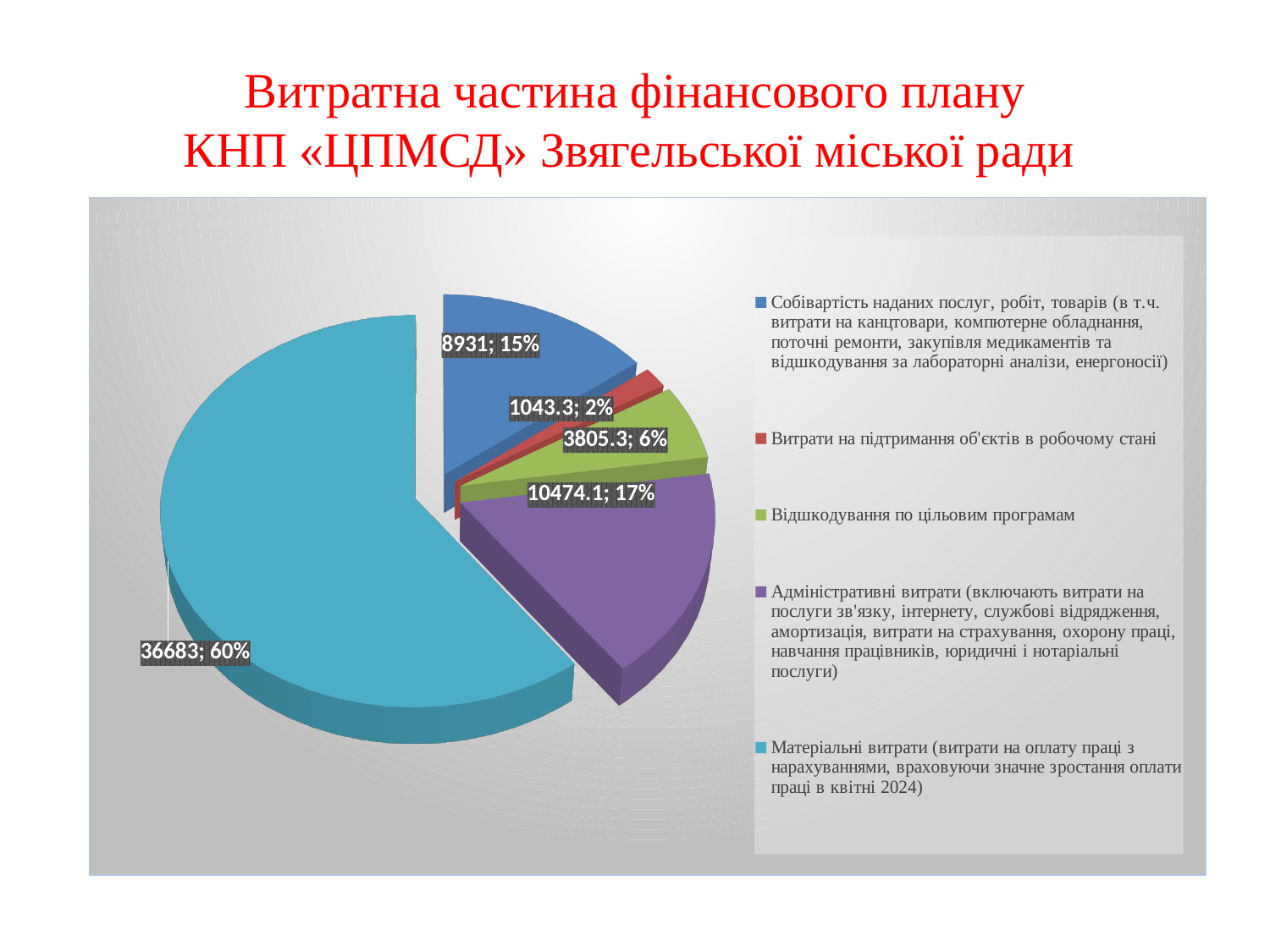
Which category has the largest slice of the pie? Матеріальні витрати What percentage is shown for 'Відшкодування по цільовим програмам'? 6% What value is shown for the slice 'Матеріальні витрати'? 36683 What kind of chart is shown on the slide? pie chart What share of the pie does 'Матеріальні витрати' represent? 60% How many entries does the legend list? 5 How many slices does the pie chart have? 5 What is the difference between the values for 'Адміністративні витрати' and 'Собівартість наданих послуг, робіт, товарів'? 1543.1 Which is larger: the value for 'Собівартість наданих послуг, робіт, товарів' or for 'Відшкодування по цільовим програмам'? Собівартість наданих послуг, робіт, товарів Which category has the smallest slice of the pie? Витрати на підтримання об'єктів в робочому стані What value is shown for 'Витрати на підтримання об'єктів в робочому стані'? 1043.3 What value is shown for 'Адміністративні витрати'? 10474.1